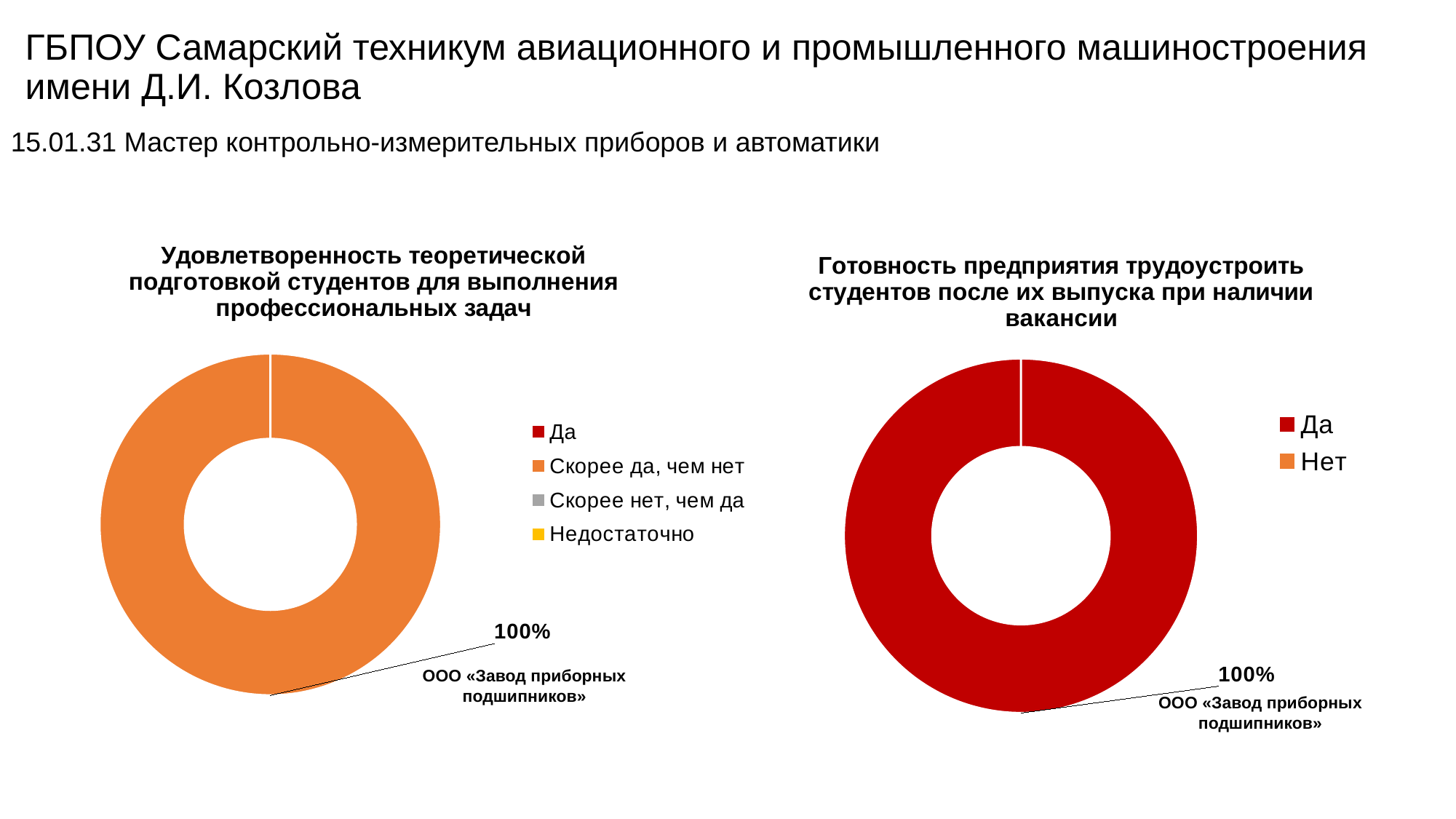
In the left chart, 'Удовлетворенность теоретической подготовкой студентов...', what colour is the legend marker for 'Недостаточно'? Yellow How many entries does the legend of the right chart, 'Готовность предприятия трудоустроить студентов...', list? 2 What kind of chart is the left chart, 'Удовлетворенность теоретической подготовкой студентов для выполнения профессиональных задач'? Doughnut (pie) chart In the right chart, 'Готовность предприятия трудоустроить студентов...', what percentage is shown on the data label? 100% Which company is named in the data label of the left chart, 'Удовлетворенность теоретической подготовкой студентов...'? ООО «Завод приборных подшипников» In the left chart, 'Удовлетворенность теоретической подготовкой студентов...', what percentage is shown on the data label? 100% What kind of chart is the right chart, 'Готовность предприятия трудоустроить студентов после их выпуска при наличии вакансии'? Doughnut (pie) chart In the right chart, 'Готовность предприятия трудоустроить студентов...', what share of the doughnut does 'Нет' occupy? 0% How many entries does the legend of the left chart, 'Удовлетворенность теоретической подготовкой студентов...', list? 4 In the left chart, 'Удовлетворенность теоретической подготовкой студентов...', which legend category does the single 100% slice belong to? Скорее да, чем нет How many visible slices does the right chart, 'Готовность предприятия трудоустроить студентов...', have? 1 In the right chart, 'Готовность предприятия трудоустроить студентов...', which legend category does the single 100% slice belong to? Да